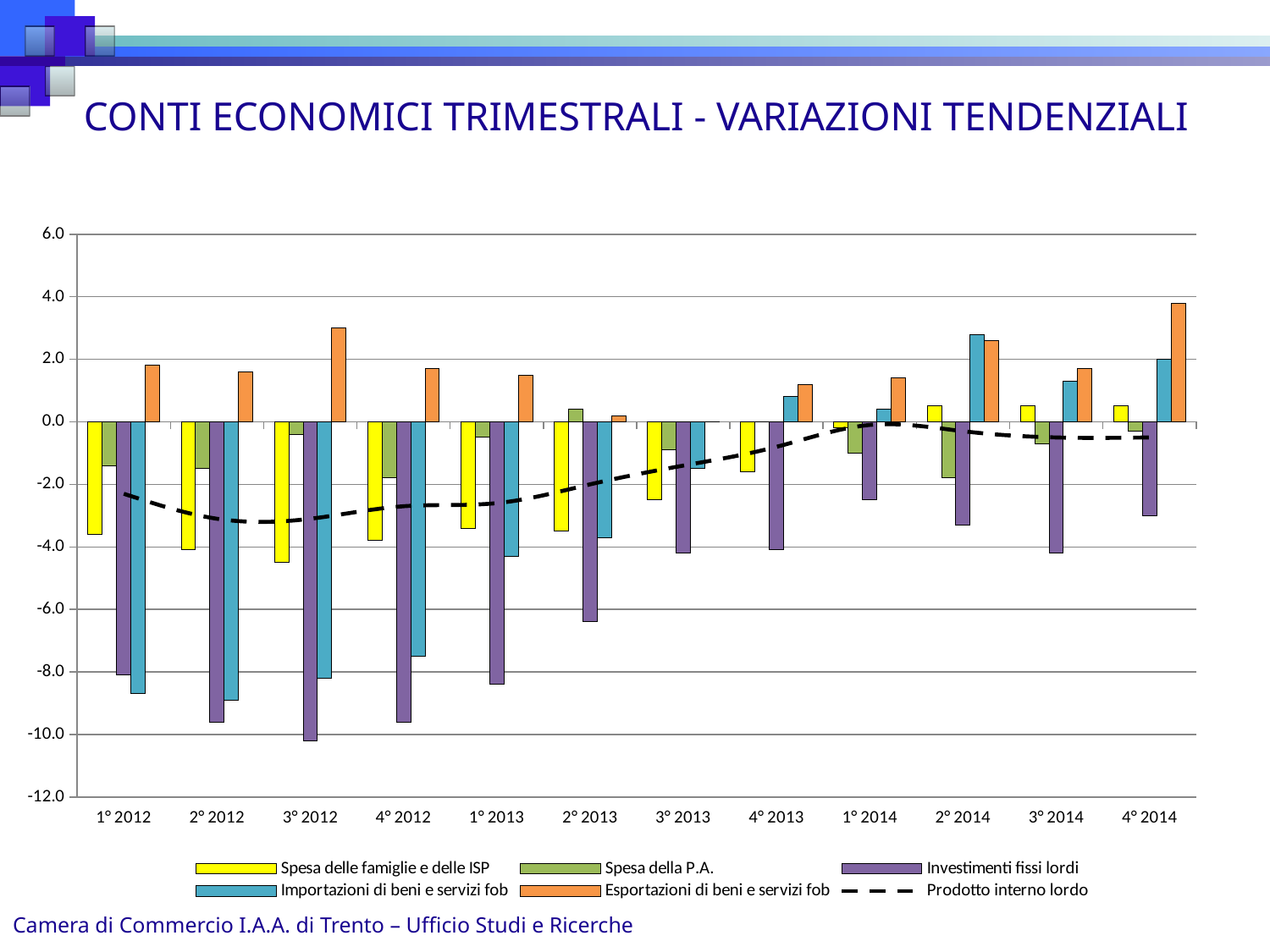
What is the title of the chart? CONTI ECONOMICI TRIMESTRALI - VARIAZIONI TENDENZIALI How many series does the legend list? 6 In 4° 2014, which is larger: Esportazioni di beni e servizi fob or Importazioni di beni e servizi fob? Esportazioni di beni e servizi fob Is the value for Spesa delle famiglie e delle ISP in 3° 2012 greater or less than -4.0? less In which quarter does Importazioni di beni e servizi fob reach its highest value? 2° 2014 Is the value for Importazioni di beni e servizi fob in 1° 2012 greater or less than -8.0? less In which quarter does Investimenti fissi lordi reach its lowest value? 3° 2012 How many quarters (categories) are shown on the x axis? 12 What kind of chart is shown on the slide? Bar chart (with a dashed line series) Is the value for Esportazioni di beni e servizi fob in 3° 2012 greater or less than 2.0? greater Which series is drawn as a dashed line rather than bars? Prodotto interno lordo In which quarter does Esportazioni di beni e servizi fob reach its highest value? 4° 2014